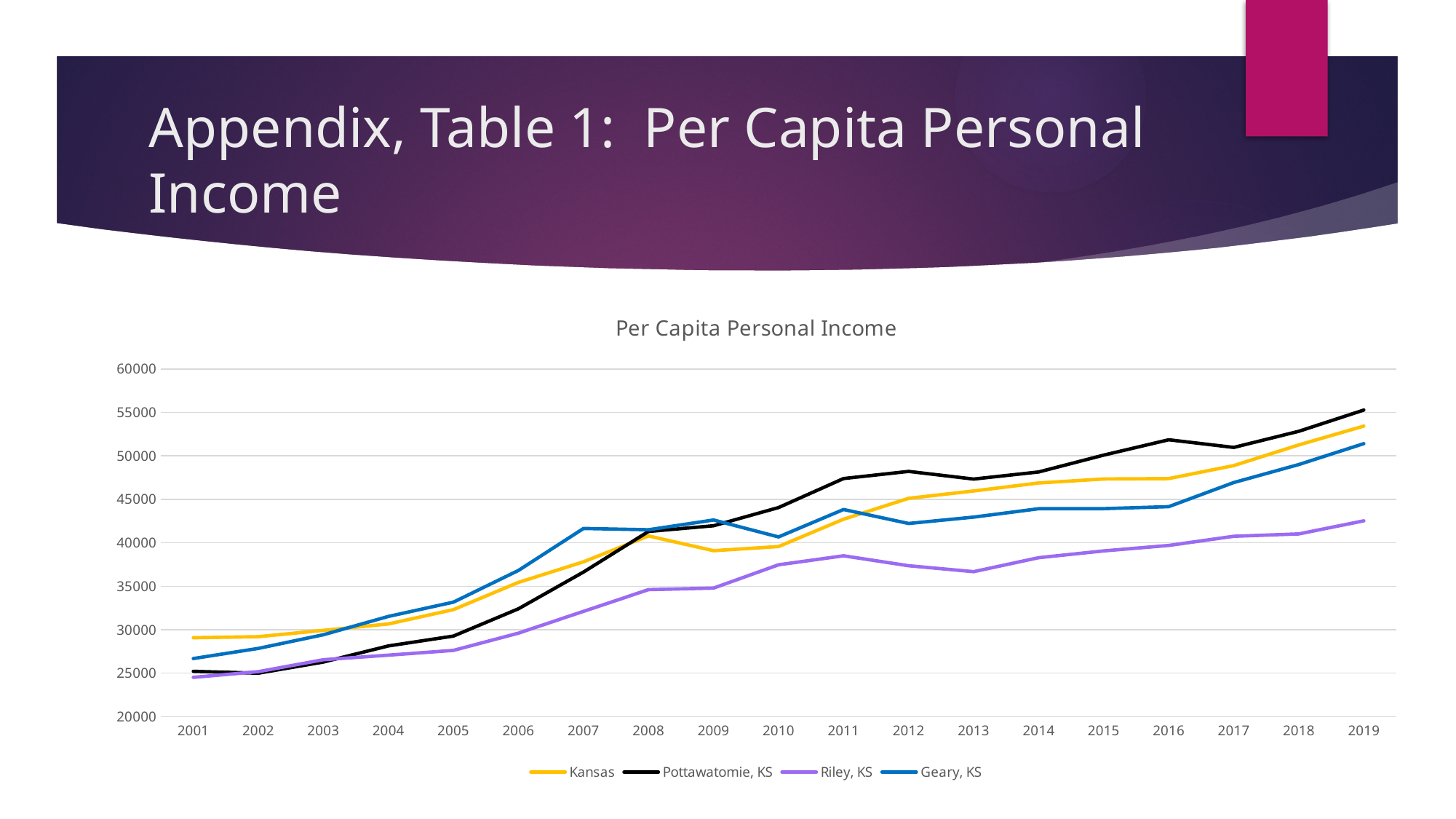
Which series has the lowest value in 2019? Riley, KS In 2007, which is larger: the value for Geary, KS or the value for Kansas? Geary, KS What is the title of the chart? Per Capita Personal Income Does the Pottawatomie, KS line generally rise or fall from 2001 to 2019? rise What kind of chart is shown on the slide? line chart Is the value for Geary, KS in 2001 greater or less than 30000? less Is the value for Riley, KS in 2019 greater or less than 45000? less Is the value for Pottawatomie, KS in 2016 greater or less than 50000? greater How many years are plotted along the x axis? 19 How many series does the legend list? 4 Which series has the highest value in 2019? Pottawatomie, KS Which series has the highest value in 2001? Kansas